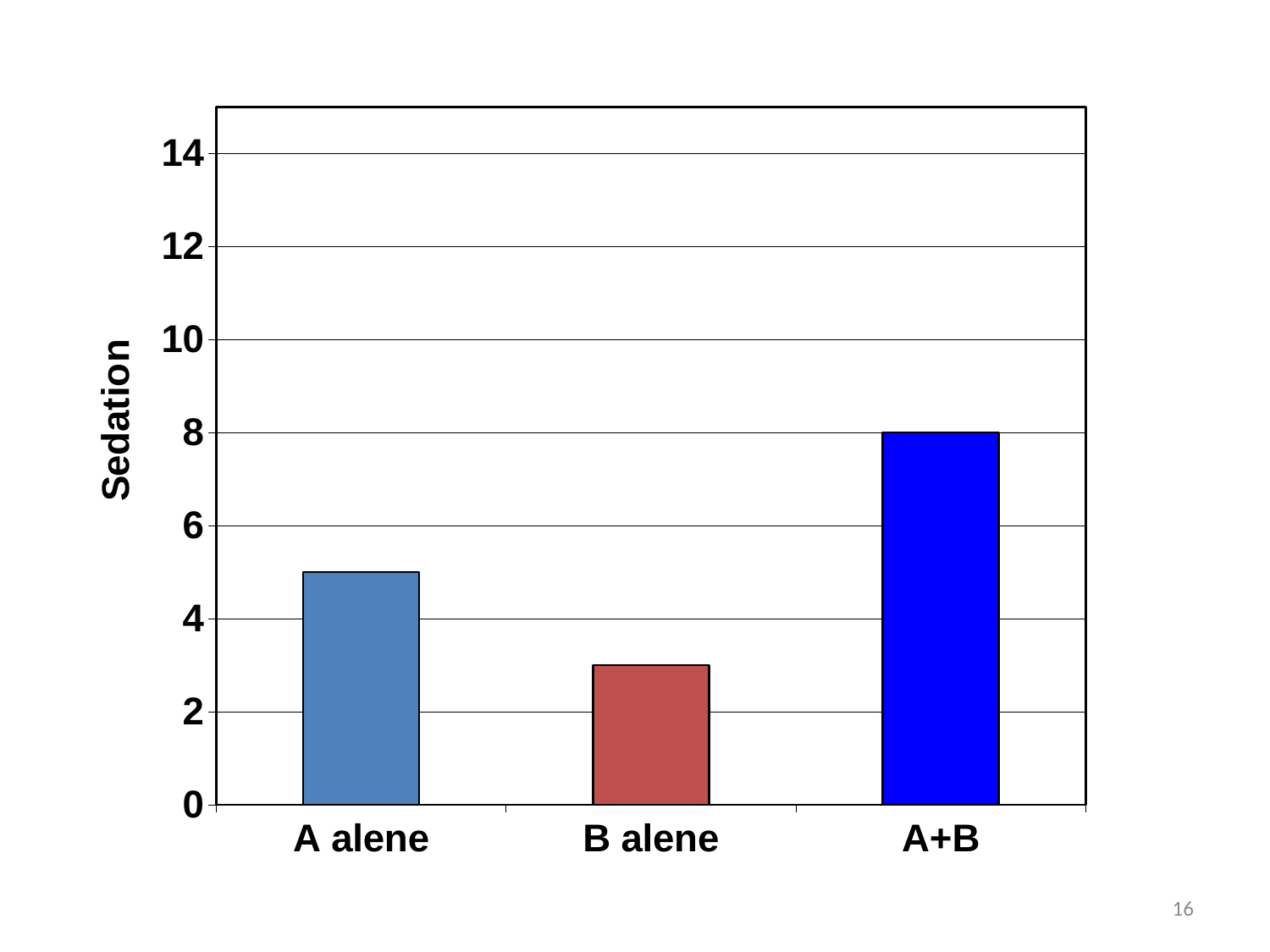
Which has a larger Sedation value, A alene or A+B? A+B Which has a larger Sedation value, A alene or B alene? A alene Is the Sedation value for A alene greater or less than 4? greater Is the Sedation value for B alene greater or less than 4? less Which category has the highest Sedation value? A+B Is the Sedation value for A alene greater or less than 6? less What is the Sedation value for A+B? 8 What type of chart is shown on the slide? bar chart What is the label on the y axis? Sedation How many categories are shown on the x axis? 3 Which category has the lowest Sedation value? B alene Does the Sedation value rise or fall from B alene to A+B? rise